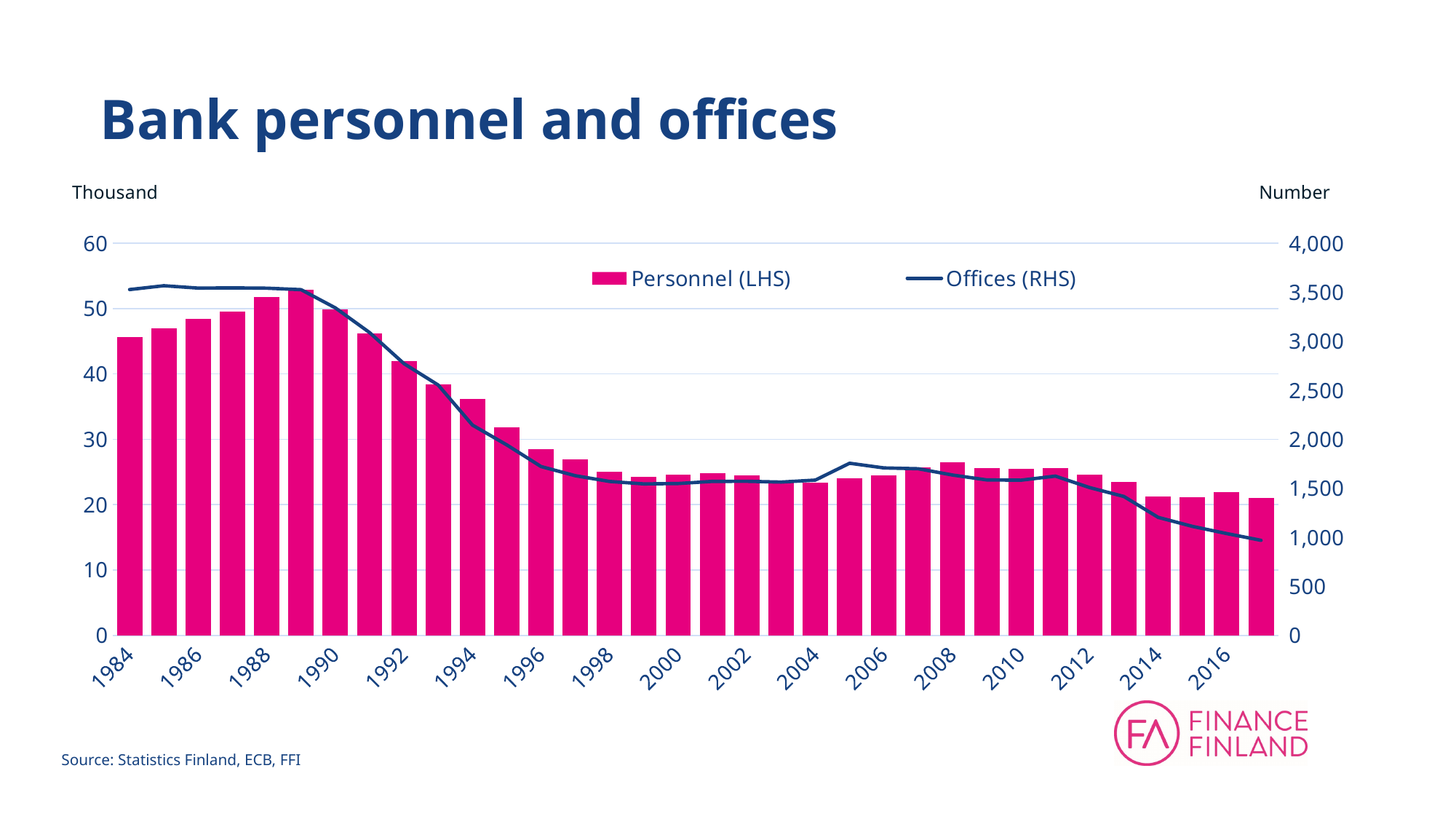
In which year is the Personnel bar highest? 1989 Is the Personnel value for 1996 greater or less than 30? less What kind of chart is shown on the slide? A bar chart combined with a line chart Which year has the larger Personnel value, 1984 or 1990? 1990 Is the Offices value for 1990 greater or less than 3,000? greater Is the Personnel value for 1984 greater or less than 40? greater How many series does the legend list? 2 What are the two series named in the legend? Personnel (LHS) and Offices (RHS) Does the Offices line rise or fall between 2011 and 2017? Falls What unit label is shown above the left-hand axis? Thousand Does the Personnel series rise or fall between 1989 and 1996? Falls